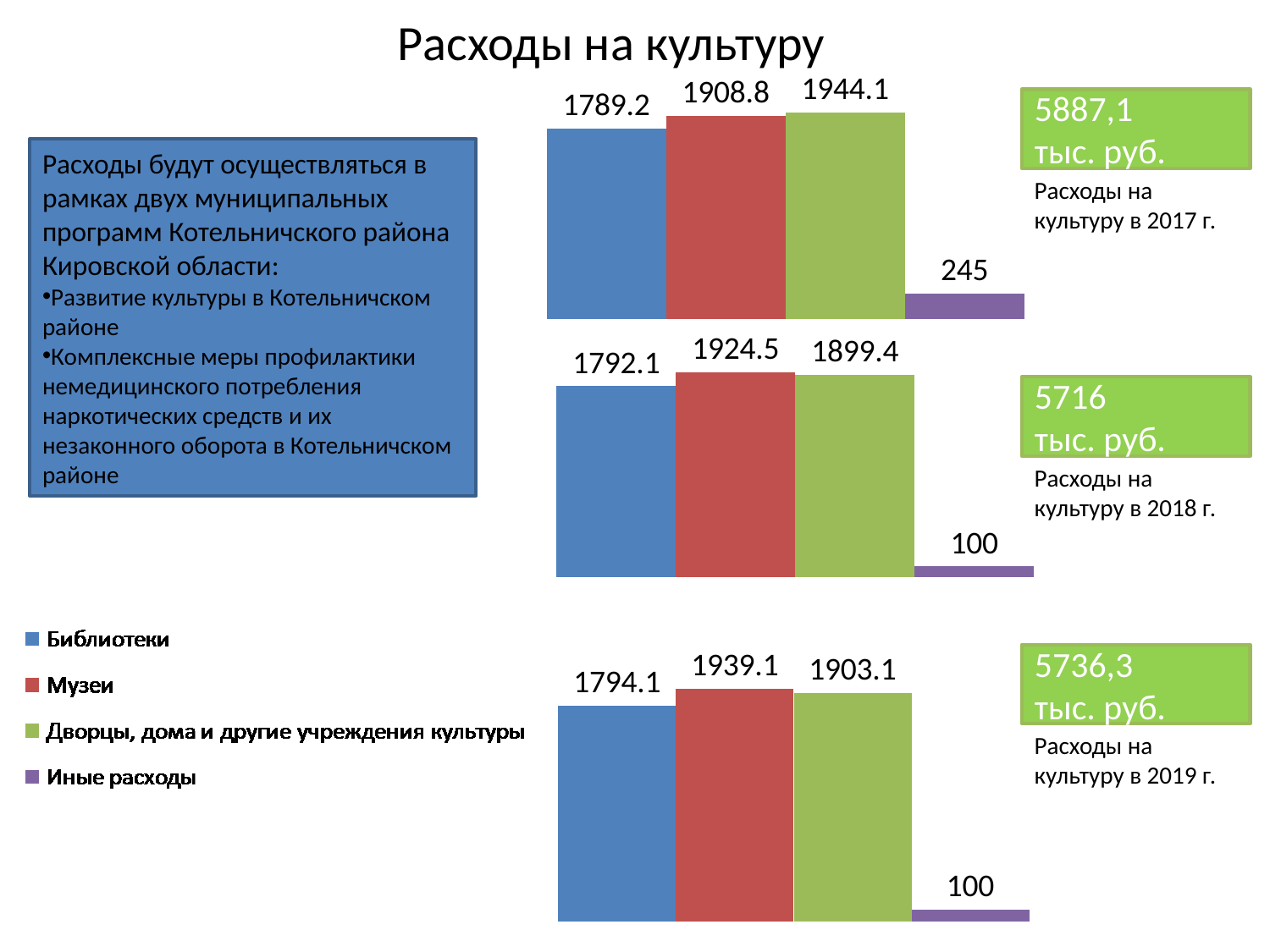
In the bottom chart (2019), what is the difference between Музеи and Библиотеки? 145 In the middle chart (2018), which category has the highest value? Музеи In the bottom chart (2019), what is the value for Иные расходы? 100 In the bottom chart (2019), which category has the lowest value? Иные расходы How many series does the legend list? 4 In the middle chart (2018), what is the value for Музеи? 1924.5 In the top chart (2017), what is the difference between Дворцы, дома и другие учреждения культуры and Музеи? 35.3 What type of chart is used for the 2019 data at the bottom of the slide? Bar chart How many bars does the top chart (2017) have? 4 In the middle chart (2018), which is larger: Музеи or Дворцы, дома и другие учреждения культуры? Музеи In the top chart (2017), which category has the highest value? Дворцы, дома и другие учреждения культуры In the top chart (2017), what is the value for Библиотеки? 1789.2